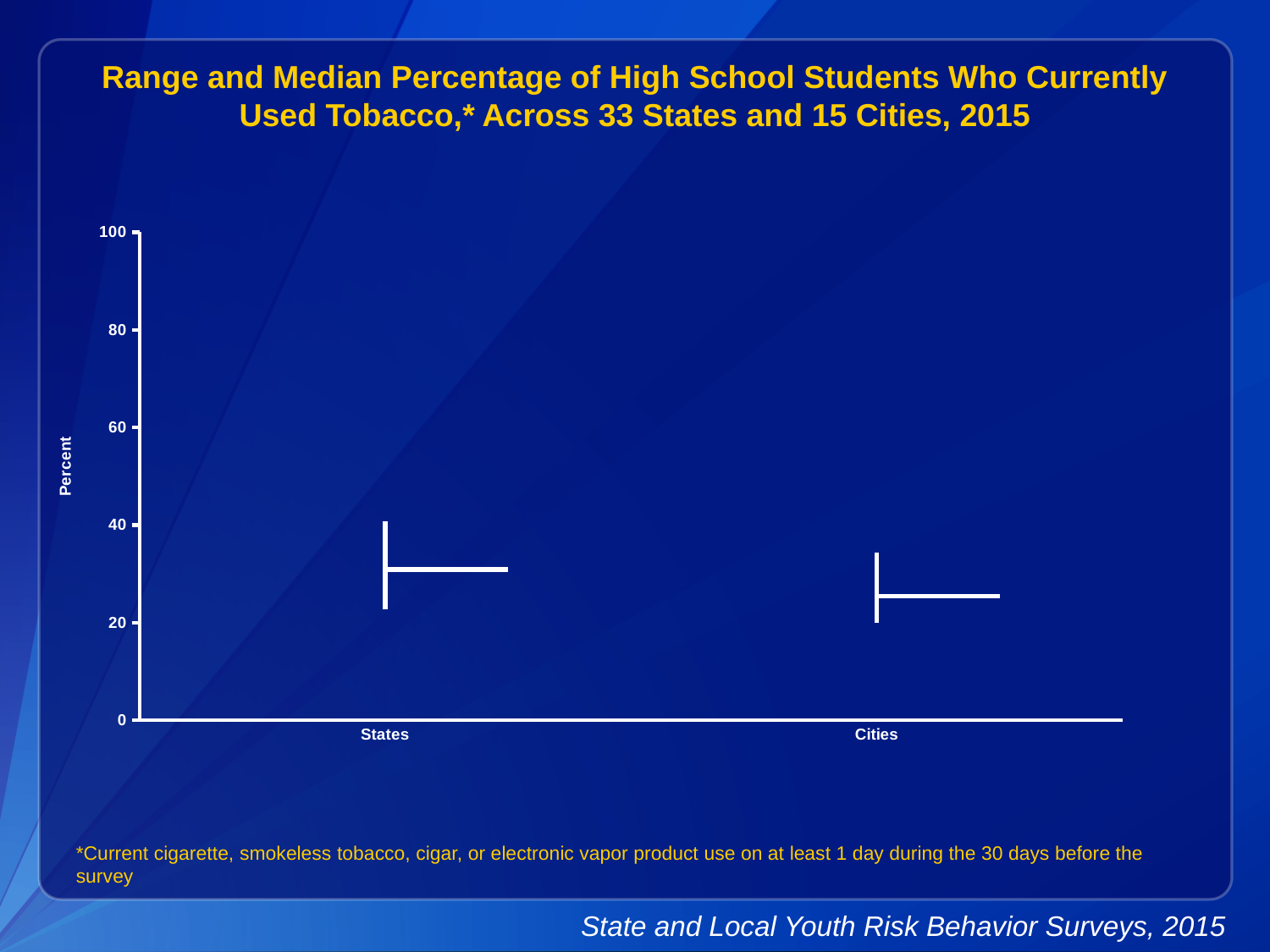
What are the two categories shown on the x axis? States and Cities Is the top of the range for States greater or less than 60? less Is the top of the range for States greater or less than 20? greater Is the median value for States greater or less than 20? greater What is the highest value shown on the y axis? 100 Which category has the higher top of its range, States or Cities? States What is the label of the y axis? Percent How many categories are shown on the x axis of the chart? 2 Which category has the higher median percentage, States or Cities? States